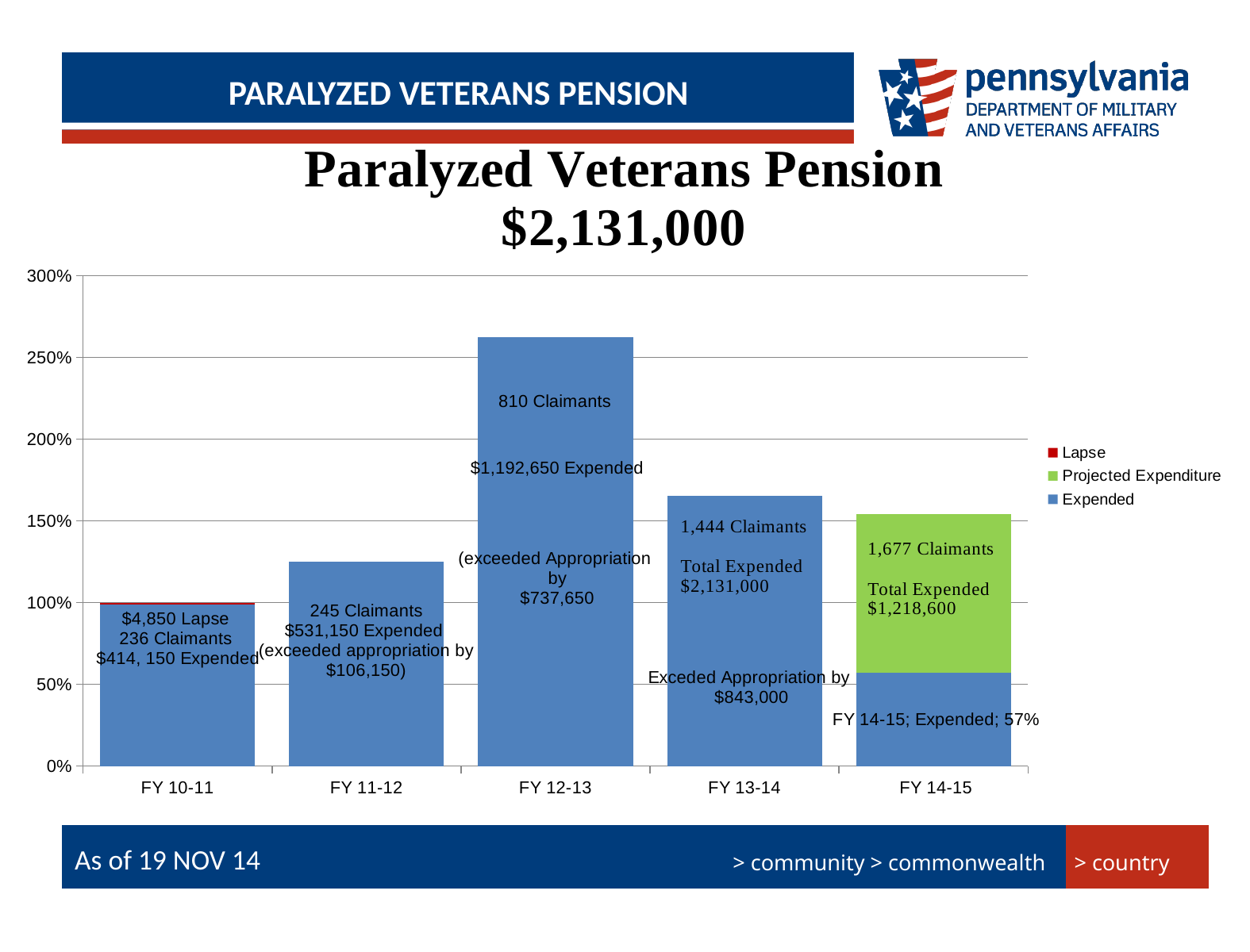
What is the Expended value labelled for FY 14-15? 57% What are the series listed in the chart legend? Lapse, Projected Expenditure, Expended Which bar is taller, FY 13-14 or FY 11-12? FY 13-14 Is the value for FY 11-12 greater or less than 150%? less Which fiscal year has the shortest bar? FY 10-11 Is the value for FY 12-13 greater or less than 250%? greater Is the value for FY 13-14 greater or less than 150%? greater How many fiscal years are shown on the x axis of the chart? 5 Which fiscal year has the tallest bar? FY 12-13 How many series does the chart legend list? 3 How many claimants are labelled on the FY 12-13 bar? 810 Claimants What kind of chart is shown on the slide? bar chart